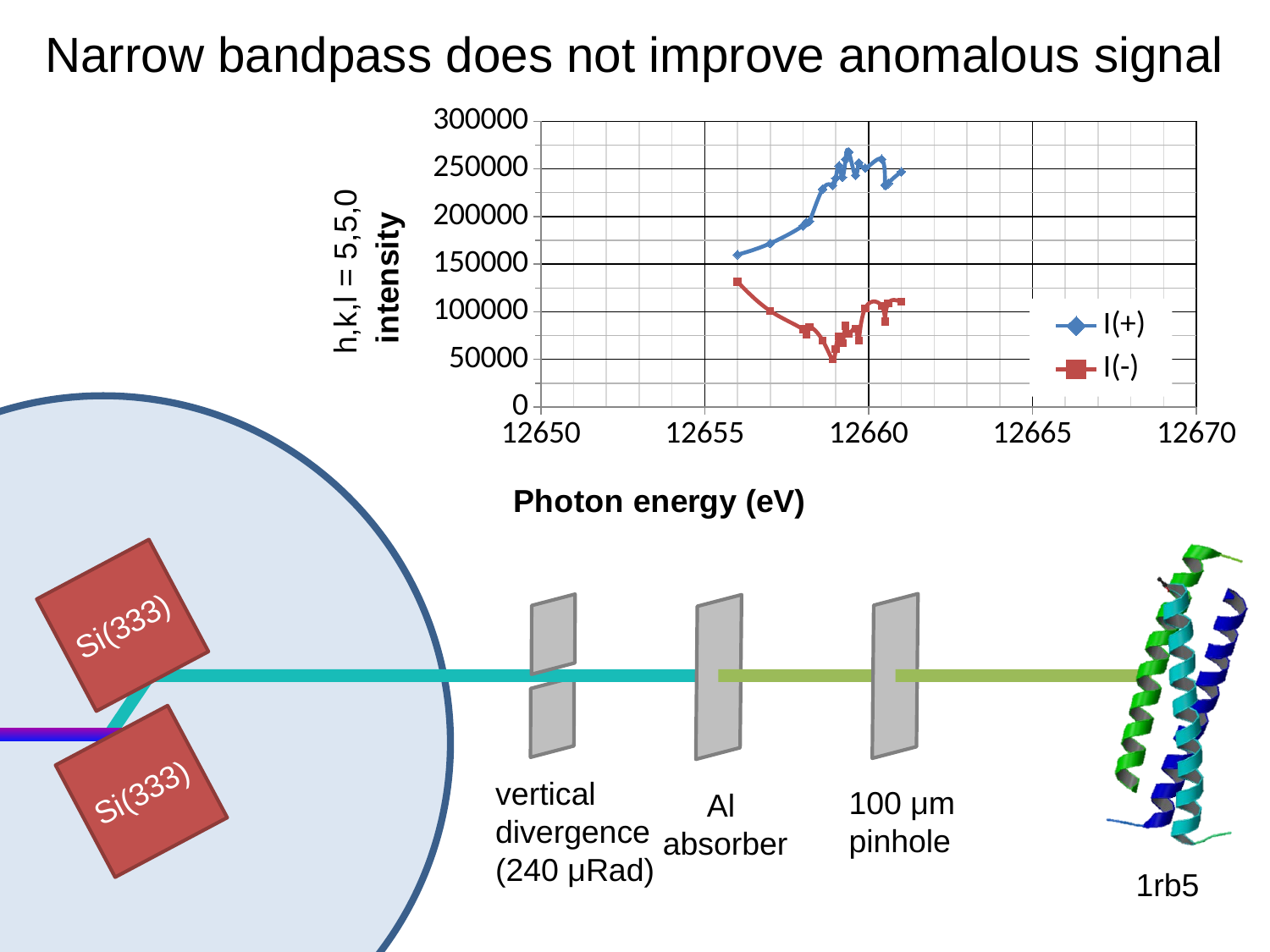
Is the I(+) value at 12656 eV greater or less than 200000? less How many series does the chart legend list? 2 Does the I(-) series rise or fall between 12656 eV and 12659 eV? fall Is the I(+) value at 12658 eV greater or less than 250000? less Is the highest I(+) value greater or less than 250000? greater At 12656 eV, which series has the larger intensity, I(+) or I(-)? I(+) What are the two series named in the chart legend? I(+) and I(-) What kind of chart is shown on the slide? line chart Does the I(+) series rise or fall between 12656 eV and 12659 eV? rise What is the x-axis label of the chart? Photon energy (eV)